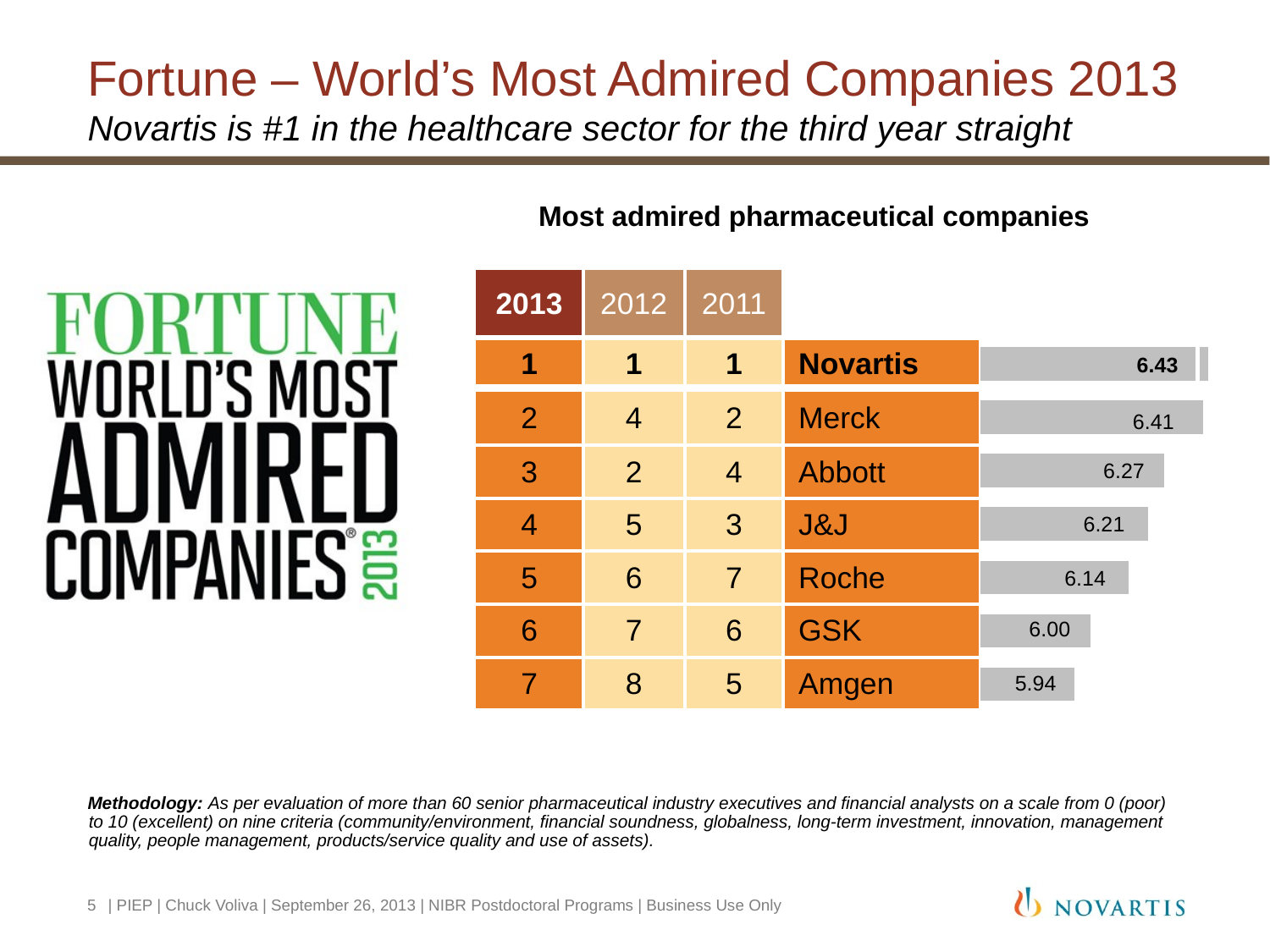
What is the score shown for Roche? 6.14 What is the difference between the scores of Abbott and GSK? 0.27 What is the title of the chart? Most admired pharmaceutical companies Which company has the highest score in the chart? Novartis Which has a higher score, J&J or Roche? J&J What kind of chart is used to show the company scores? Bar chart How many companies are shown in the chart? 7 What is the score shown for Novartis in the Most admired pharmaceutical companies chart? 6.43 What is the score shown for Amgen? 5.94 Which company has the lowest score in the chart? Amgen What is the difference between the scores of Novartis and Amgen? 0.49 What is the score shown for Merck? 6.41